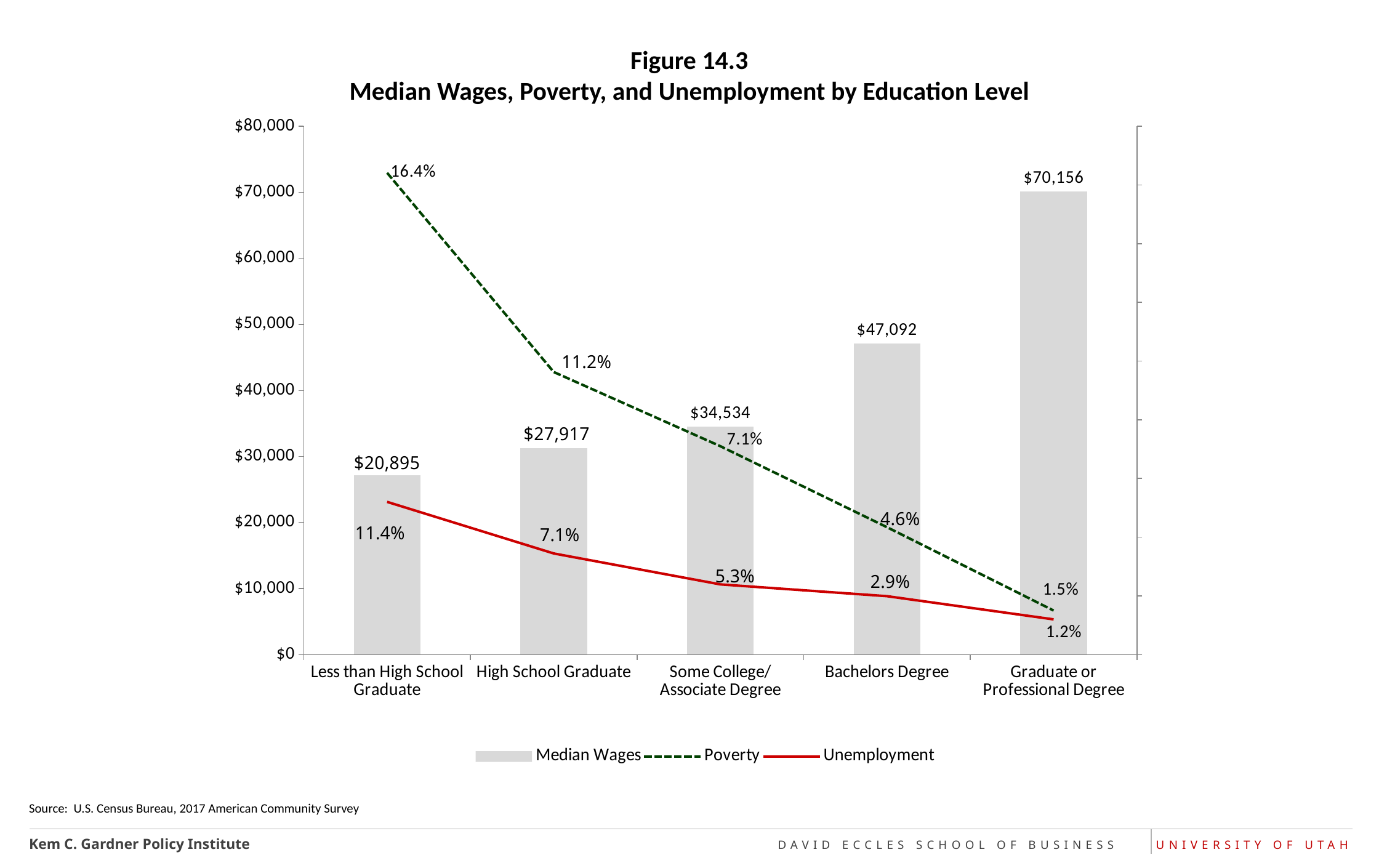
How many series does the legend list? 3 Which series is drawn as a dashed green line? Poverty Is the median wage for Some College/Associate Degree greater or less than $30,000? greater What is the unemployment rate for Some College/Associate Degree? 5.3% What is the median wage for Bachelors Degree? $47,092 How many education levels are shown on the x axis? 5 What is the difference in median wages between Graduate or Professional Degree and Less than High School Graduate? $49,261 Which education level has the lowest poverty rate? Graduate or Professional Degree How do the poverty and unemployment rates change as education level increases from left to right? They fall What is the poverty rate for High School Graduate? 11.2% Which is larger, the poverty rate for Less than High School Graduate or the unemployment rate for Less than High School Graduate? Poverty rate (16.4%) Which education level has the highest median wage? Graduate or Professional Degree